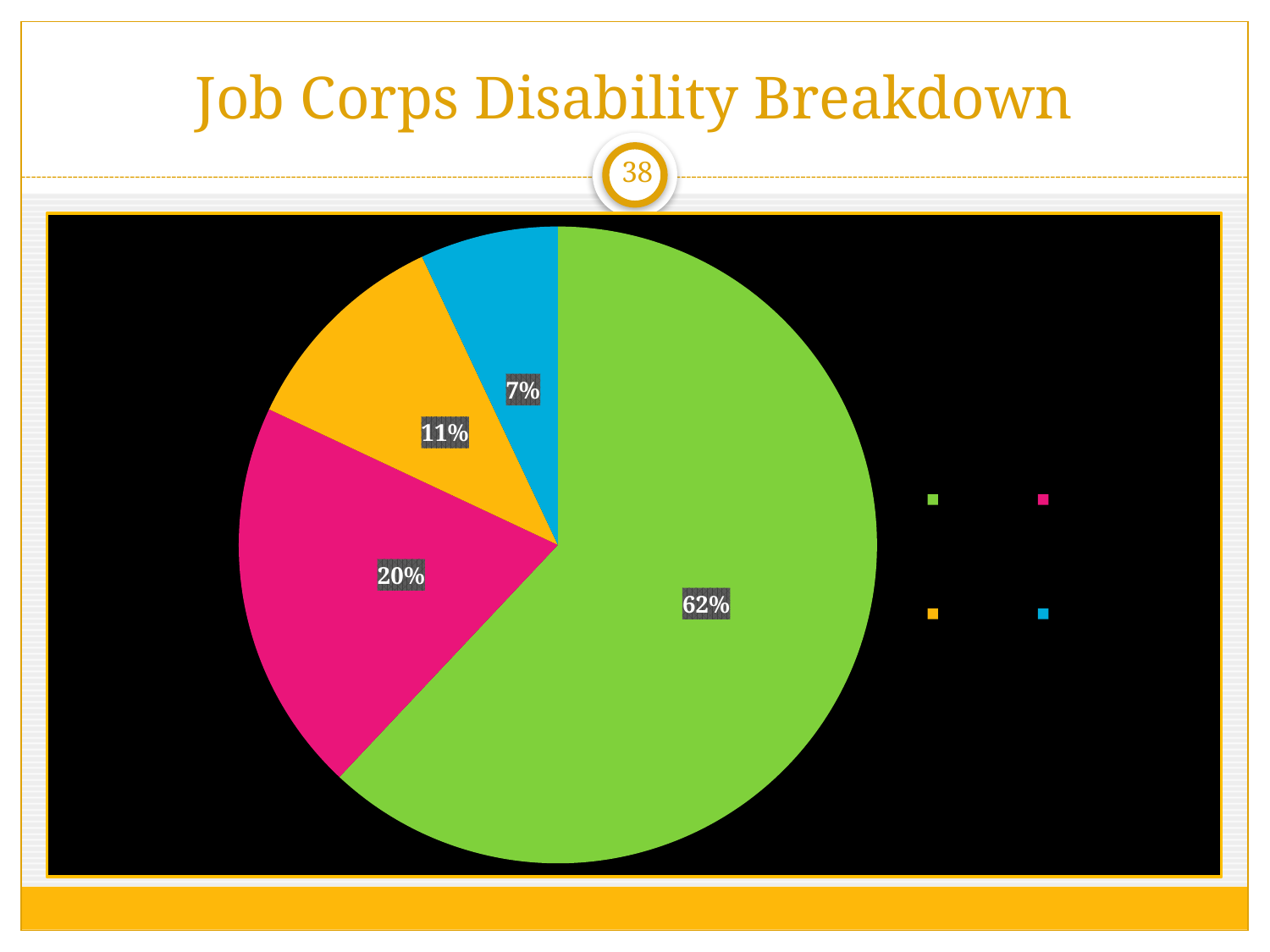
What percentage is shown on the smallest slice of the pie chart? 7% What percentage is shown on the pink slice of the pie chart? 20% What kind of chart is shown on the slide? pie chart What percentage is shown on the green slice of the pie chart? 62% Which slice is larger, the orange slice or the blue slice? orange What is the title of the slide containing the pie chart? Job Corps Disability Breakdown How many entries does the legend of the pie chart show? 4 What percentage is shown on the orange slice of the pie chart? 11% What is the difference in percentage points between the green slice and the pink slice? 42 What percentage is shown on the blue slice of the pie chart? 7% How many slices does the pie chart have? 4 What percentage is shown on the largest slice of the pie chart? 62%